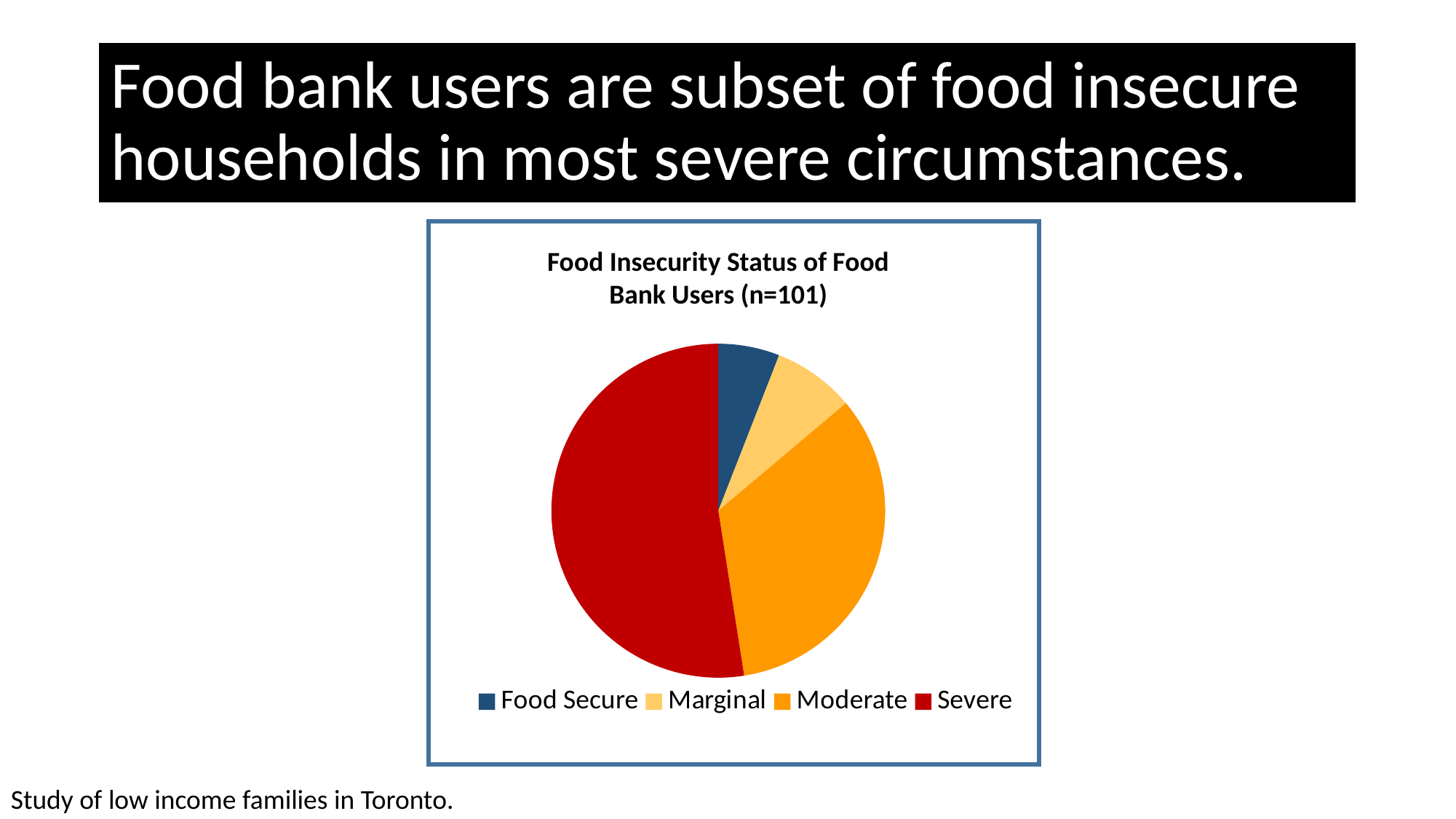
Which slice is larger, Severe or Moderate? Severe How many entries does the chart legend list? 4 Which slice is larger, Moderate or Food Secure? Moderate Which slice is larger, Moderate or Marginal? Moderate How many categories does the pie chart show? 4 Which category has the largest slice of the pie? Severe What is the title of the chart? Food Insecurity Status of Food Bank Users (n=101) Which category has the smallest slice of the pie? Food Secure What is the sample size (n) stated in the chart title? 101 What kind of chart is shown on the slide? Pie chart What colour is the Severe slice in the pie chart? Red